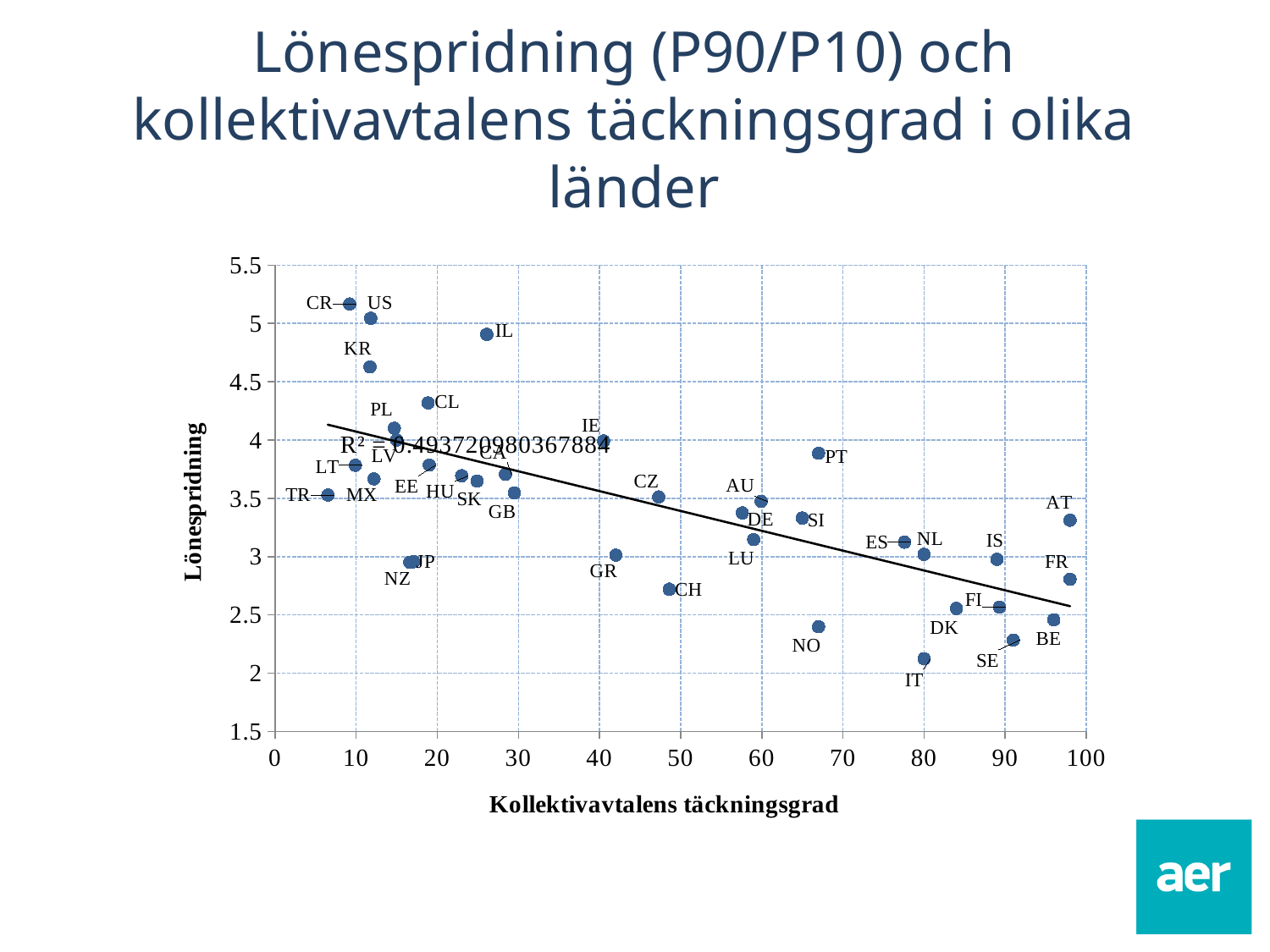
What is the title of the chart's vertical axis? Lönespridning Which country has the lowest Lönespridning value in the chart? IT Which has the higher Lönespridning value, GR or CH? GR Is the Lönespridning value for IT greater or less than 2.5? less Which country has the lowest Kollektivavtalens täckningsgrad in the chart? TR Is the Kollektivavtalens täckningsgrad for TR greater or less than 10? less What is the title of the chart's horizontal axis? Kollektivavtalens täckningsgrad What kind of chart is shown on the slide? scatter chart As Kollektivavtalens täckningsgrad increases along the x axis, does Lönespridning generally rise or fall according to the trend line? fall Is the Lönespridning value for CR greater or less than 5? greater Which has the higher Lönespridning value, PT or SI? PT